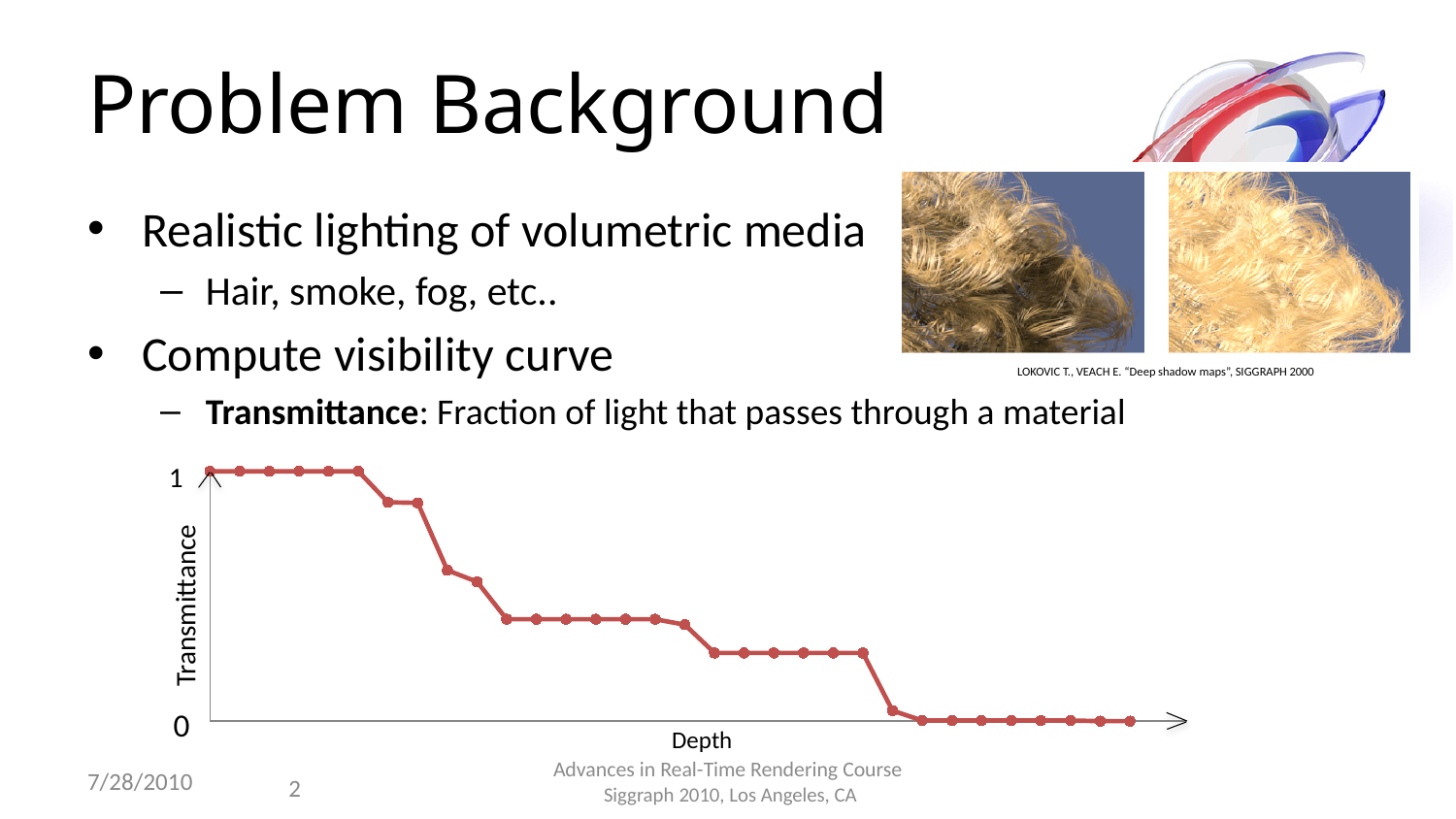
What is the transmittance value at the rightmost point of the curve? 0 What is the highest tick value shown on the y axis? 1 Does the transmittance rise or fall as depth increases along the x axis? fall Is the transmittance at the middle of the depth range greater or less than 1? less What is the label of the x axis of the chart? Depth What is the lowest tick value shown on the y axis? 0 What is the difference between the transmittance at the leftmost point and at the rightmost point of the curve? 1 What is the label of the y axis of the chart? Transmittance What kind of chart is shown on the slide? line chart Which has the higher transmittance, the leftmost point or the rightmost point of the curve? the leftmost point What is the transmittance value at the leftmost point of the curve? 1